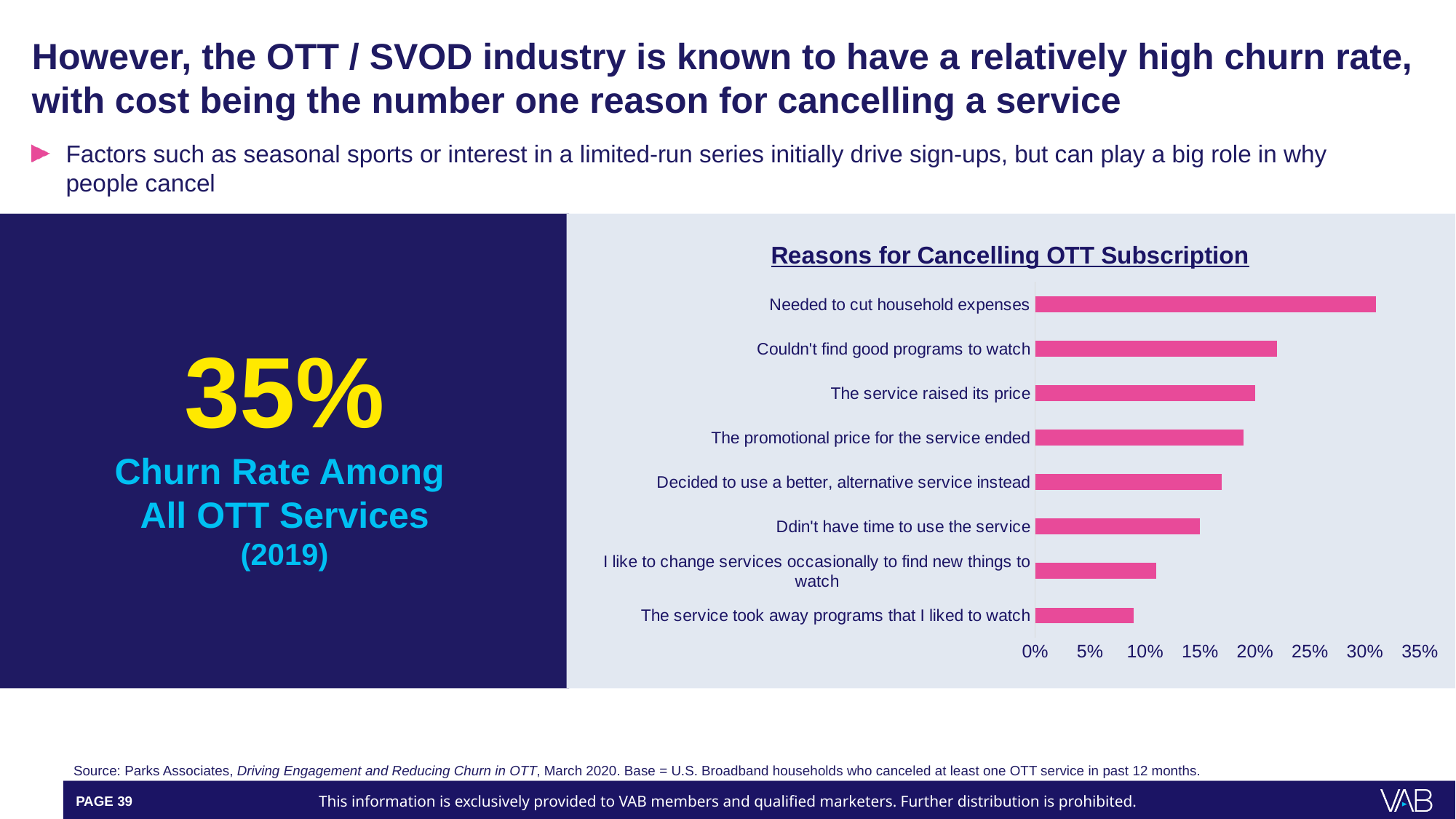
What is the title of the chart? Reasons for Cancelling OTT Subscription Which reason for cancelling has the highest value? Needed to cut household expenses Is the value for 'Couldn't find good programs to watch' greater or less than 25%? less Is the value for 'I like to change services occasionally to find new things to watch' greater or less than 15%? less Which is larger: the value for 'Needed to cut household expenses' or the value for 'Couldn't find good programs to watch'? Needed to cut household expenses Which is larger: the value for 'Decided to use a better, alternative service instead' or the value for 'The service took away programs that I liked to watch'? Decided to use a better, alternative service instead Is the value for 'Decided to use a better, alternative service instead' greater or less than 20%? less How many reasons for cancelling are listed in the chart? 8 What kind of chart is shown on the slide? bar chart Which reason for cancelling has the lowest value? The service took away programs that I liked to watch